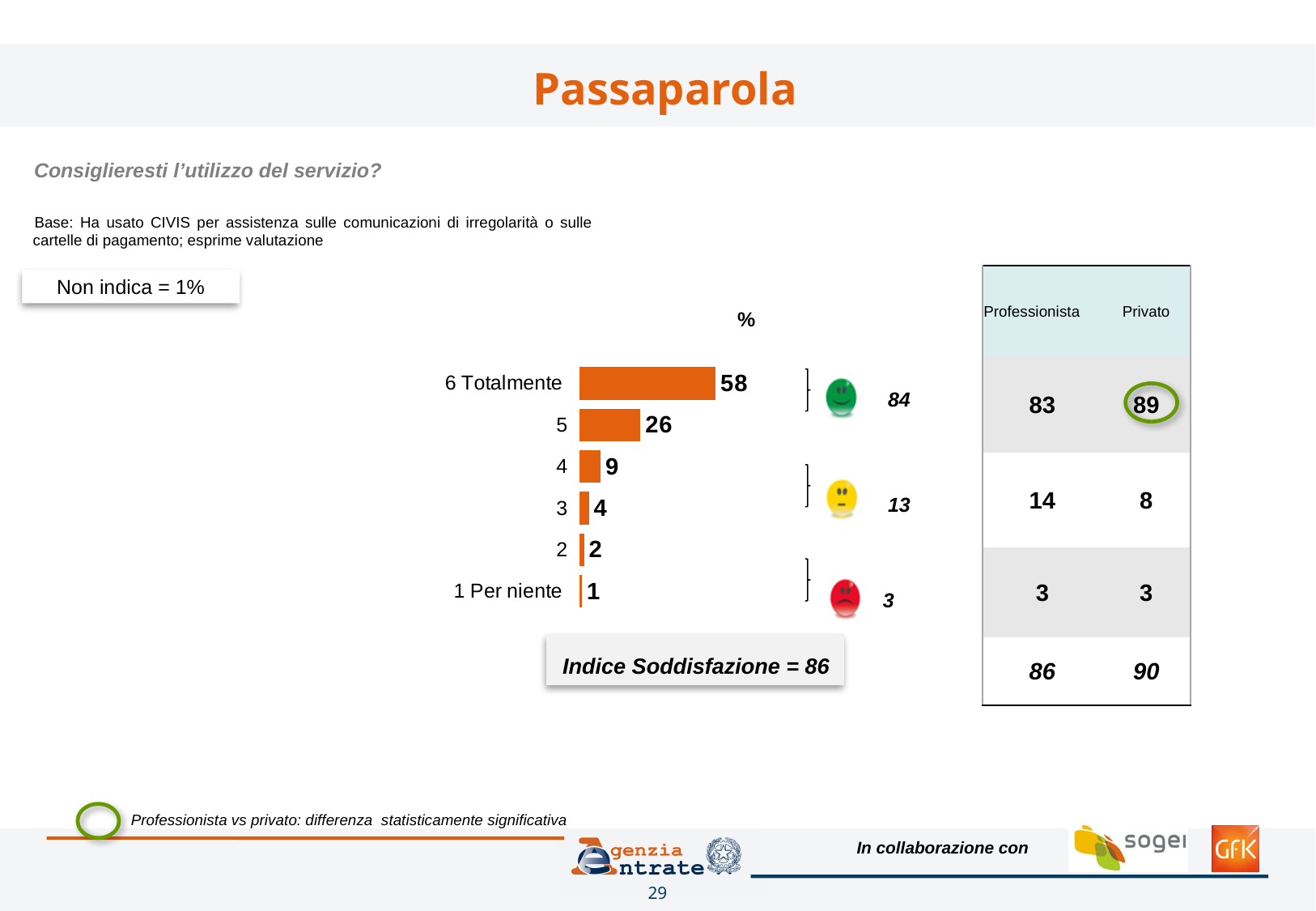
What kind of chart is shown on the slide? bar chart What is the value for category "5" in the bar chart? 26 How many categories are shown in the bar chart? 6 Which category has the highest value in the bar chart? 6 Totalmente What colour are the bars in the chart? orange What is the difference between the values for "6 Totalmente" and "5"? 32 What is the value for category "4" in the bar chart? 9 Do the bar values increase or decrease going from "6 Totalmente" down to "1 Per niente"? decrease Which category has the lowest value in the bar chart? 1 Per niente What is the value for "1 Per niente" in the bar chart? 1 Which is larger, the value for category "3" or category "2"? 3 What is the value for "6 Totalmente" in the bar chart? 58